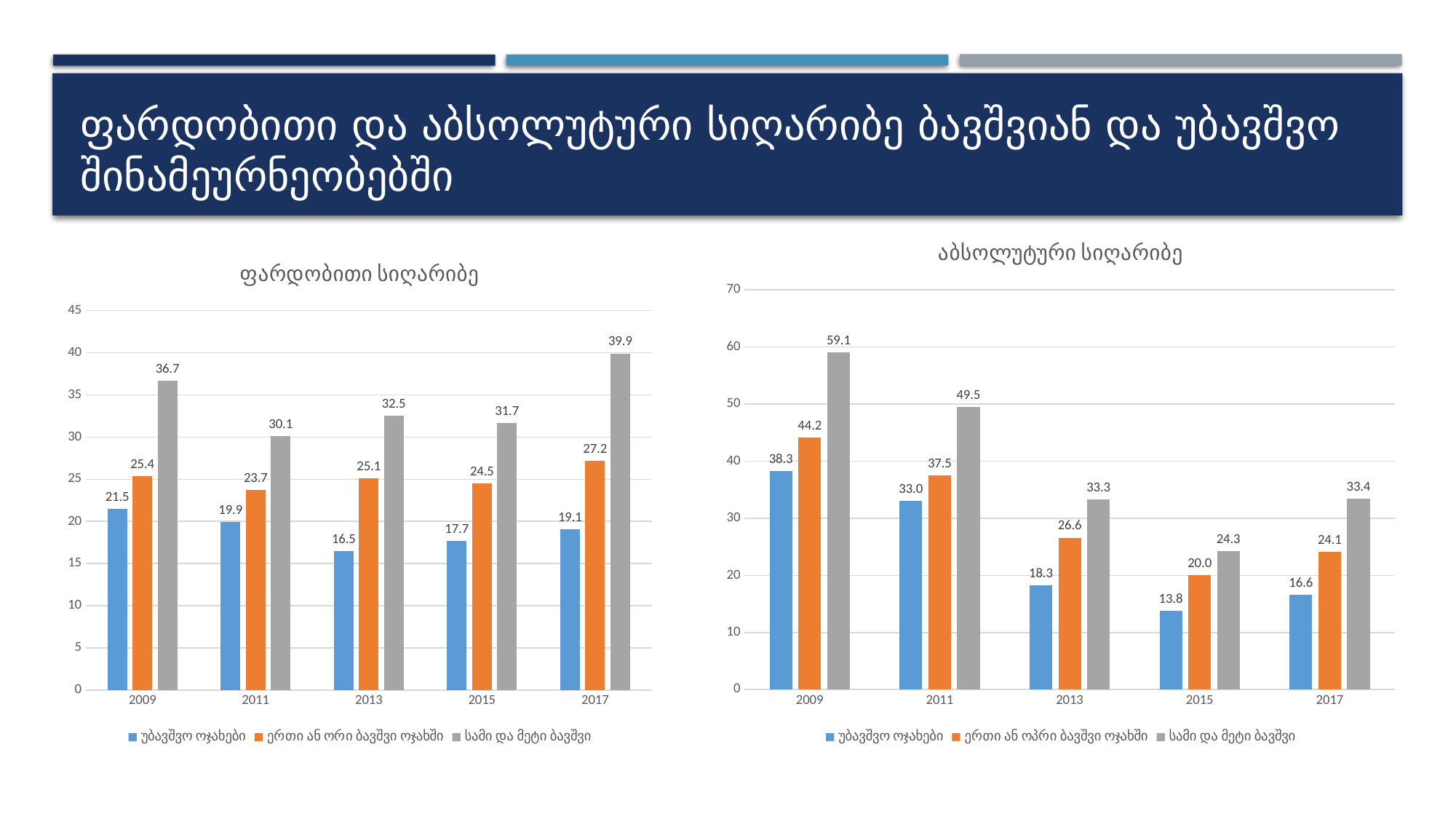
In the right chart (აბსოლუტური სიღარიბე), which is larger in 2013: ერთი ან ორი ბავშვი ოჯახში or უბავშვო ოჯახები? ერთი ან ორი ბავშვი ოჯახში In the right chart (აბსოლუტური სიღარიბე), does the value for უბავშვო ოჯახები rise or fall from 2009 to 2015? fall In the left chart (ფარდობითი სიღარიბე), what is the value for სამი და მეტი ბავშვი in 2017? 39.9 In the left chart (ფარდობითი სიღარიბე), what is the difference between სამი და მეტი ბავშვი and უბავშვო ოჯახები in 2009? 15.2 In the right chart (აბსოლუტური სიღარიბე), what is the value for ერთი ან ორი ბავშვი ოჯახში in 2015? 20.0 In the right chart (აბსოლუტური სიღარიბე), what is the value for უბავშვო ოჯახები in 2009? 38.3 In the right chart (აბსოლუტური სიღარიბე), is the value for სამი და მეტი ბავშვი in 2011 greater or less than 40? greater In the right chart (აბსოლუტური სიღარიბე), what is the difference between the 2009 and 2017 values for სამი და მეტი ბავშვი? 25.7 How many years are shown on the x axis of the left chart (ფარდობითი სიღარიბე)? 5 How many series does the legend of the right chart (აბსოლუტური სიღარიბე) list? 3 In the left chart (ფარდობითი სიღარიბე), which year has the lowest value for უბავშვო ოჯახები? 2013 In the right chart (აბსოლუტური სიღარიბე), which year has the highest value for სამი და მეტი ბავშვი? 2009